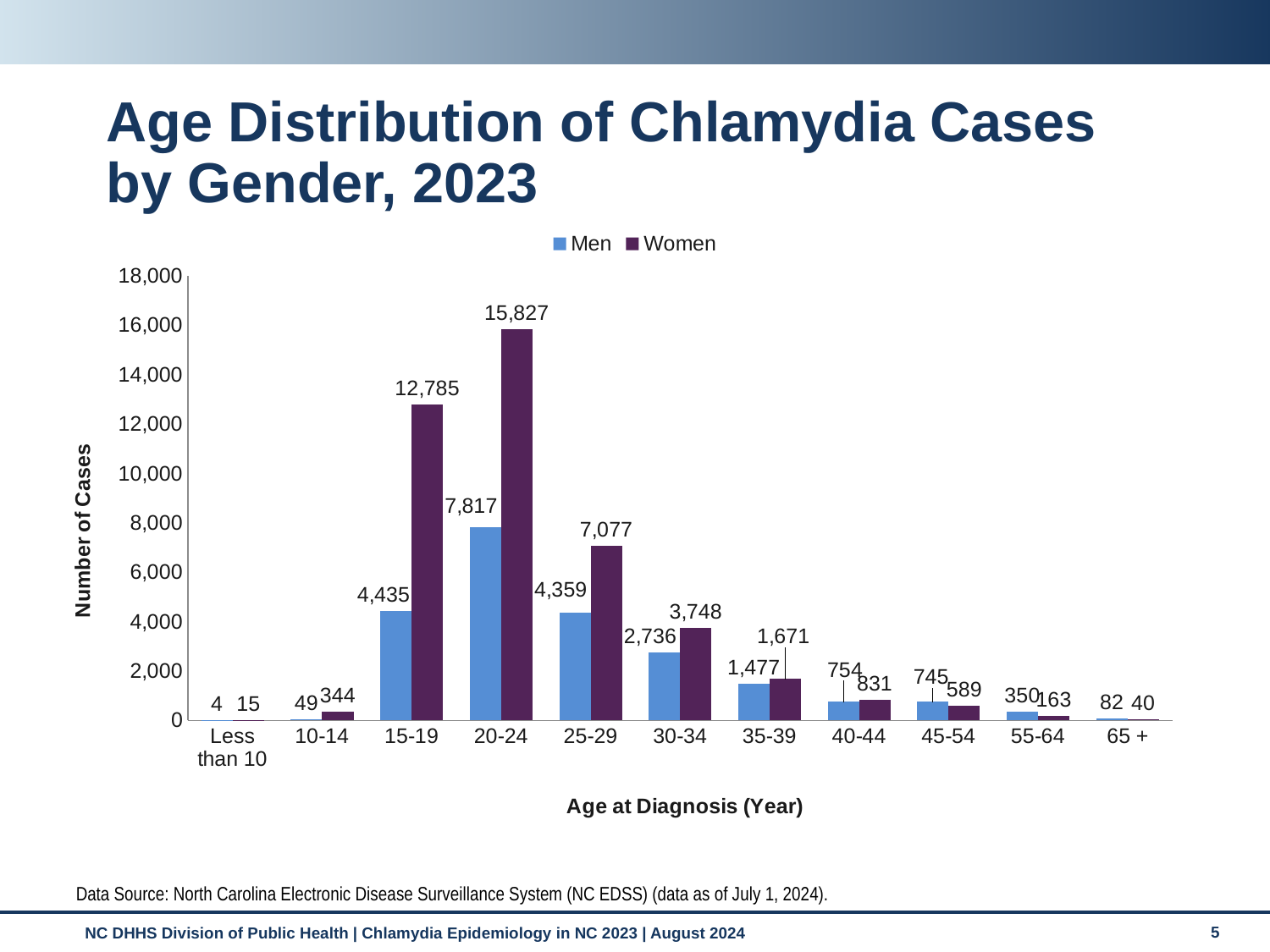
How many chlamydia cases were reported among women aged 20-24? 15,827 What is the total number of cases (men plus women) in the 30-34 age group? 6,484 Which age group has the highest number of cases among women? 20-24 What kind of chart is shown on the slide? Bar chart What is the label of the y axis? Number of Cases In the 45-54 age group, are there more cases among men or women? Men What is the difference between women and men cases in the 15-19 age group? 8,350 Do the number of cases among women rise or fall from the 20-24 age group to the 65 + age group? Fall Which age group has the lowest number of cases among men? Less than 10 How many chlamydia cases were reported among men aged 15-19? 4,435 How many series does the legend list? 2 How many age groups are shown on the x axis? 11